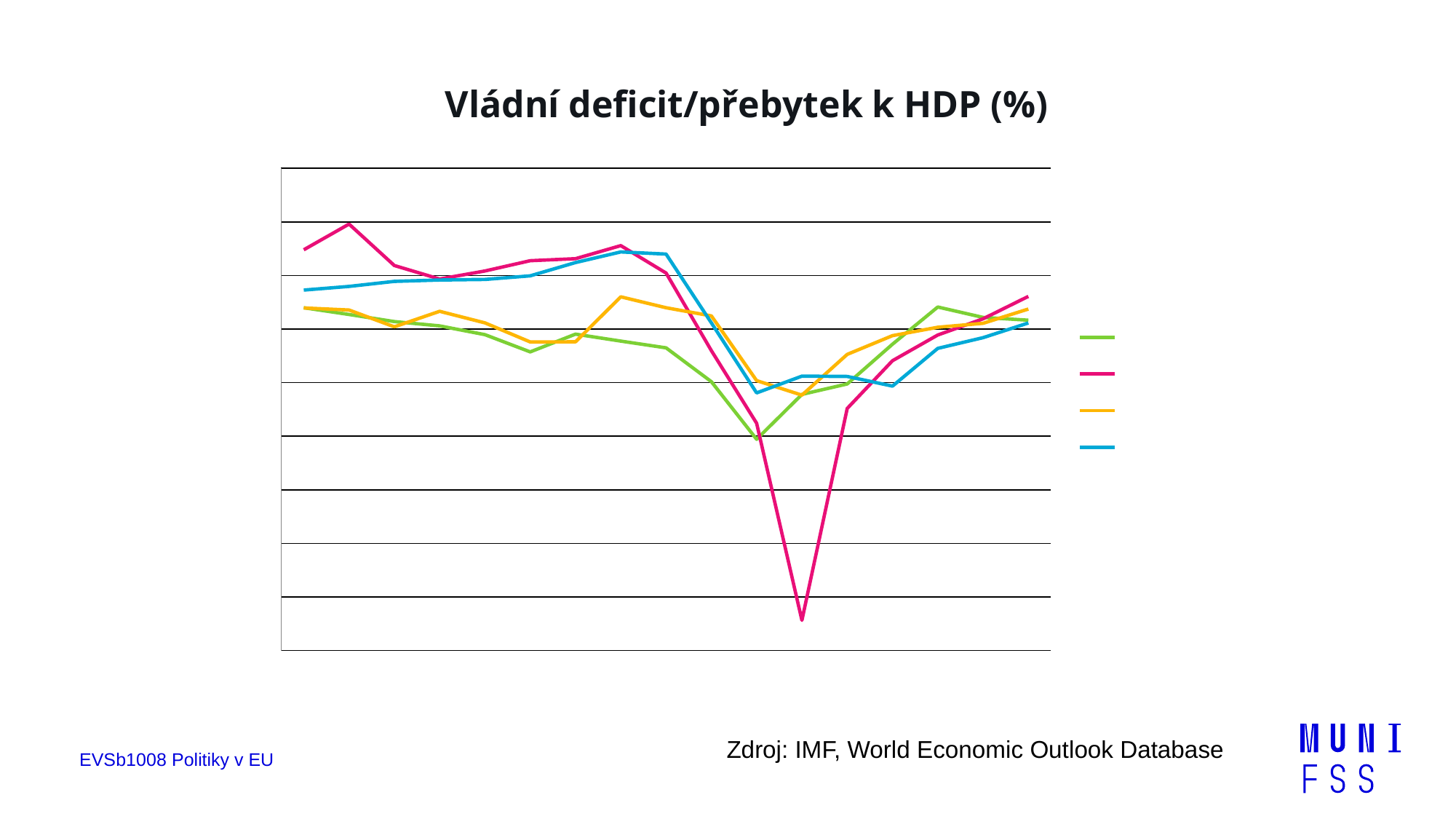
What source is cited below the chart? IMF, World Economic Outlook Database What is the title of the chart? Vládní deficit/přebytek k HDP (%) How many series does the legend list? 4 What kind of chart is shown on the slide? line chart Which coloured line drops to the lowest point on the chart? the pink line